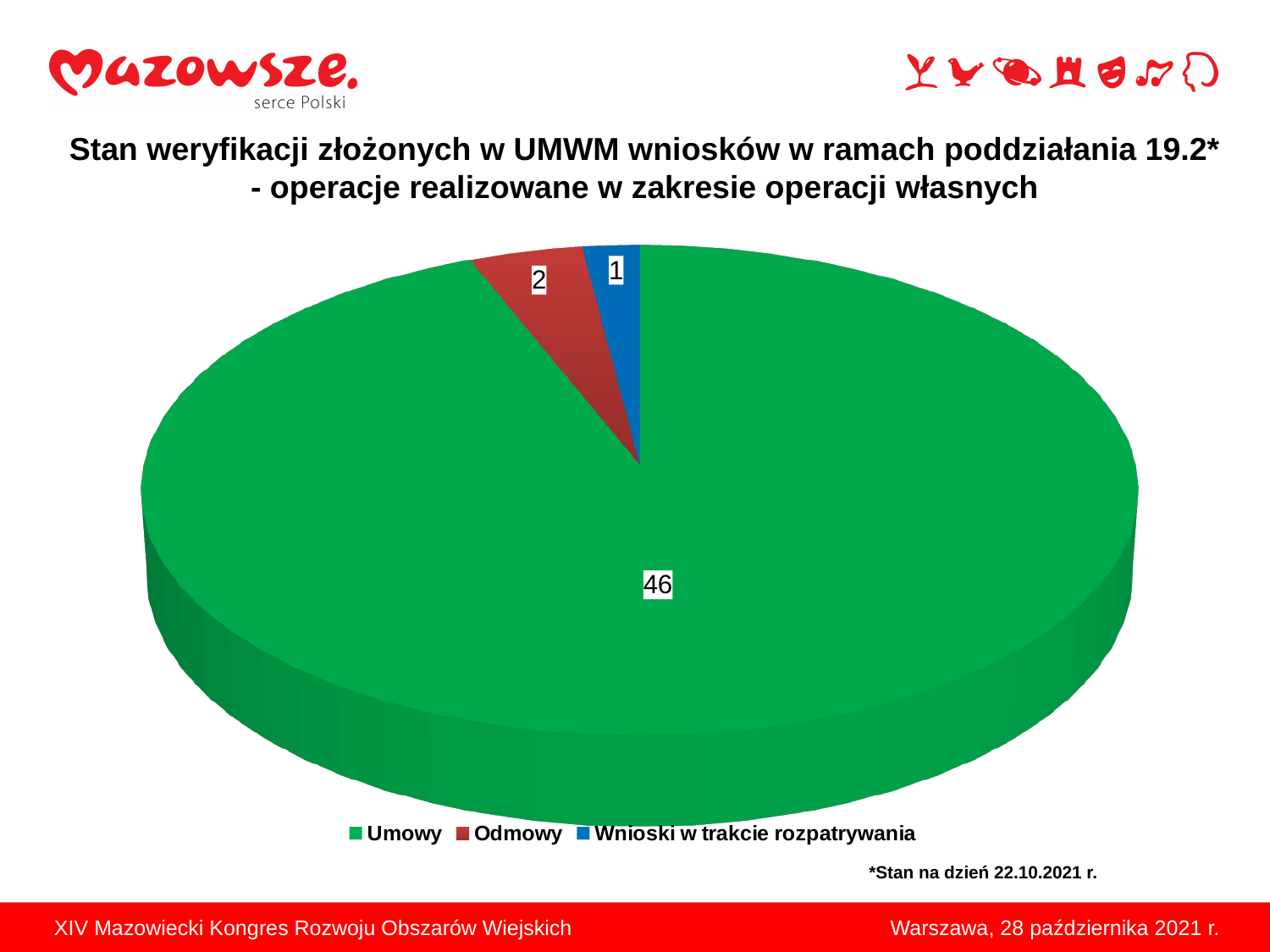
Which category has the smallest slice of the pie? Wnioski w trakcie rozpatrywania What colour is the slice for Odmowy? red Which category has the largest slice of the pie? Umowy What is the difference between the values for Umowy and Odmowy? 44 What is the value for Odmowy? 2 How many categories does the pie chart have? 3 What is the value for Wnioski w trakcie rozpatrywania? 1 What type of chart is shown on the slide? pie chart What is the total of all slices in the pie chart? 49 What is the value for Umowy? 46 What share of the total does Umowy represent? 46 out of 49 Which is larger, the value for Odmowy or the value for Wnioski w trakcie rozpatrywania? Odmowy